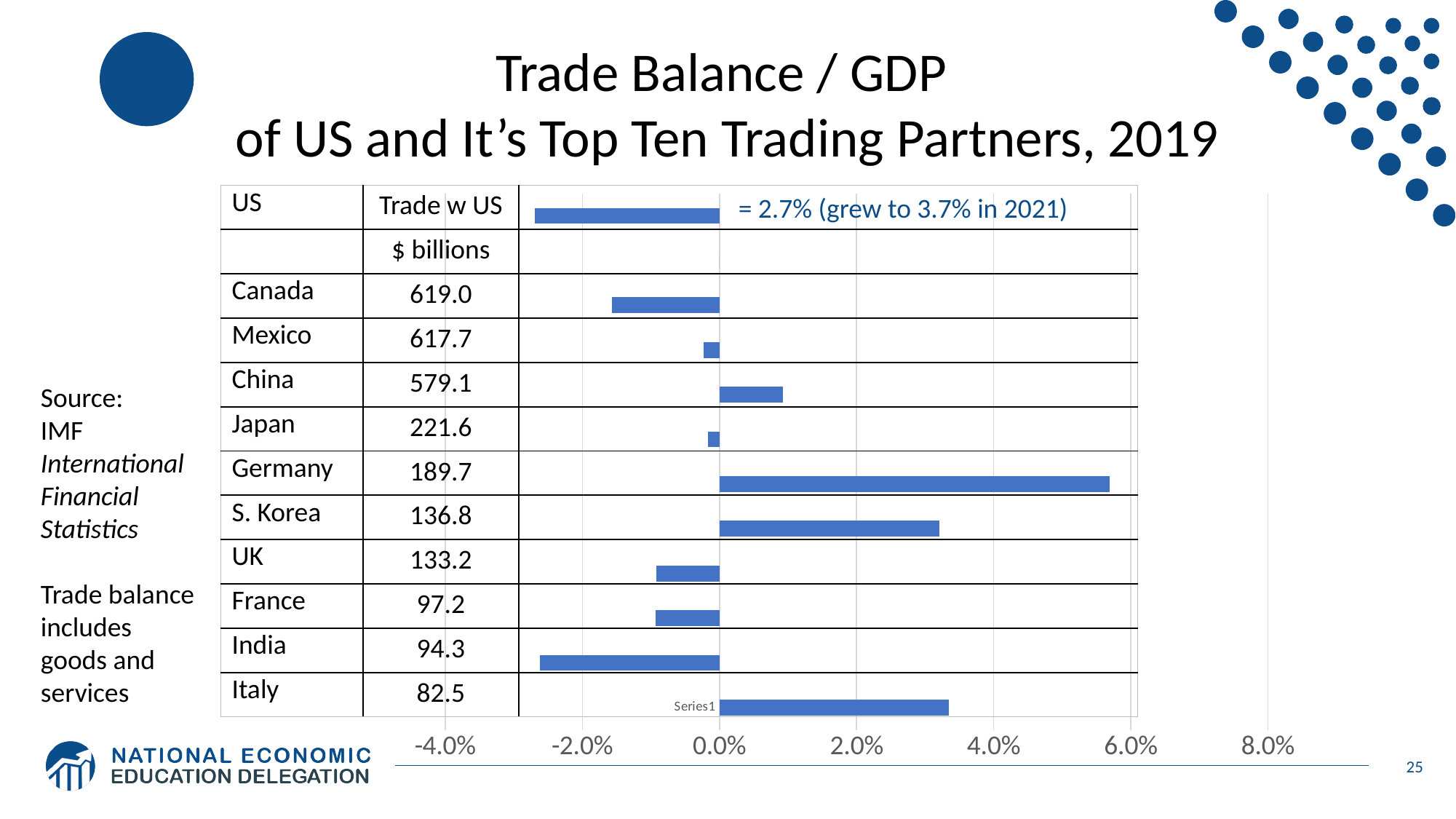
Is the value for India greater or less than -2.0%? less Is the value for Germany greater or less than 4.0%? greater Is the value for S. Korea greater or less than 2.0%? greater According to the annotation on the chart, what did the US trade balance / GDP grow to in 2021? 3.7% How many countries (including the US) have bars plotted on the chart? 11 Which has the larger trade balance / GDP value, China or Germany? Germany What is the highest value shown on the horizontal axis of the chart? 8.0% Which country has the highest trade balance / GDP bar on the chart? Germany Which has the larger trade balance / GDP value, Germany or S. Korea? Germany What kind of chart is shown on the slide? bar chart